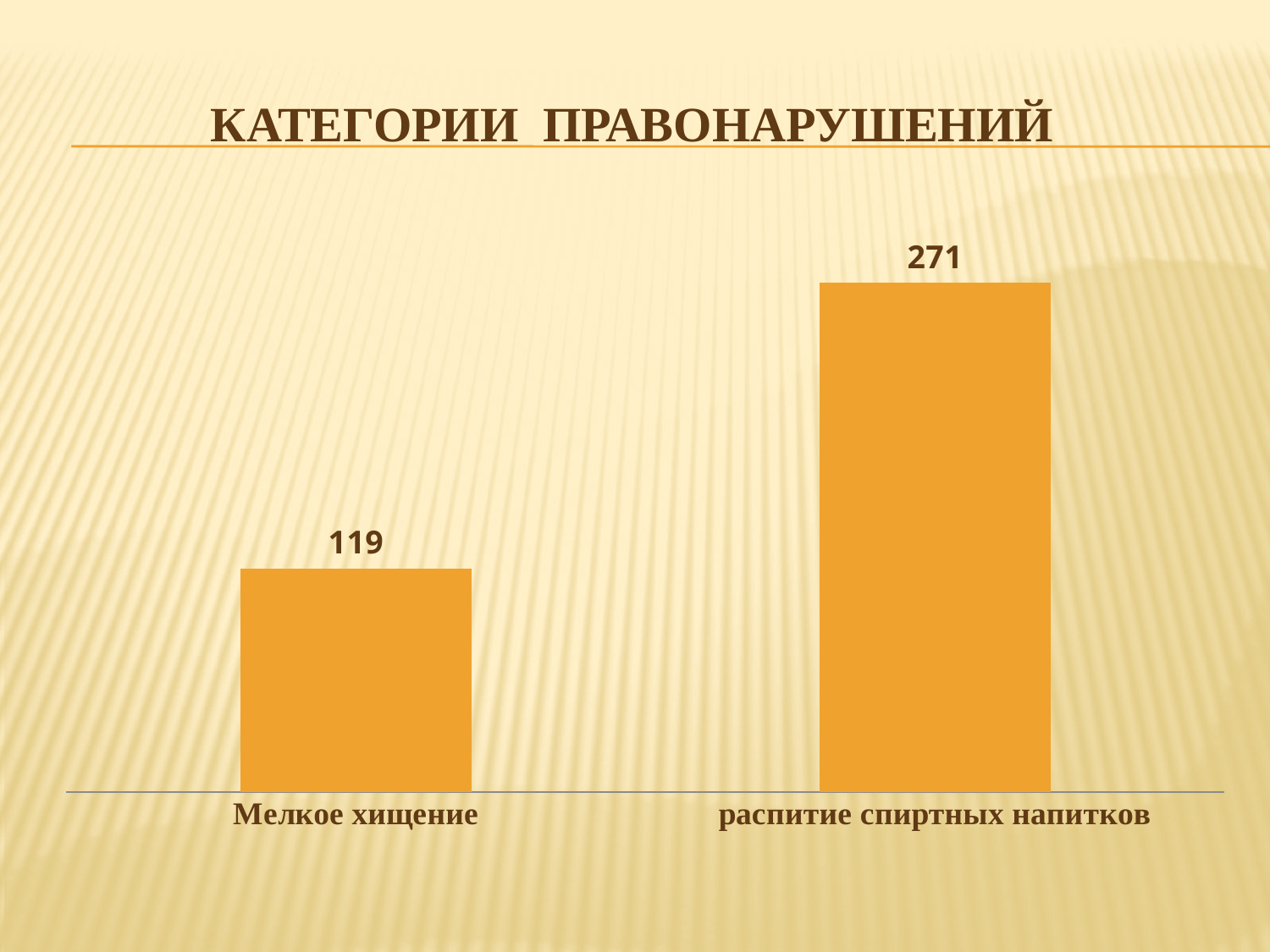
Which category has the highest value? распитие спиртных напитков What colour are the bars in the chart? Orange What kind of chart is shown on the slide? Bar chart What is the value for распитие спиртных напитков? 271 How many categories are shown in the chart? 2 What is the value for Мелкое хищение? 119 Which category has the lowest value? Мелкое хищение Which is larger: the value for Мелкое хищение or the value for распитие спиртных напитков? распитие спиртных напитков What is the total of the two values shown in the chart? 390 What is the difference between the values for распитие спиртных напитков and Мелкое хищение? 152 What is the title of the slide? КАТЕГОРИИ ПРАВОНАРУШЕНИЙ